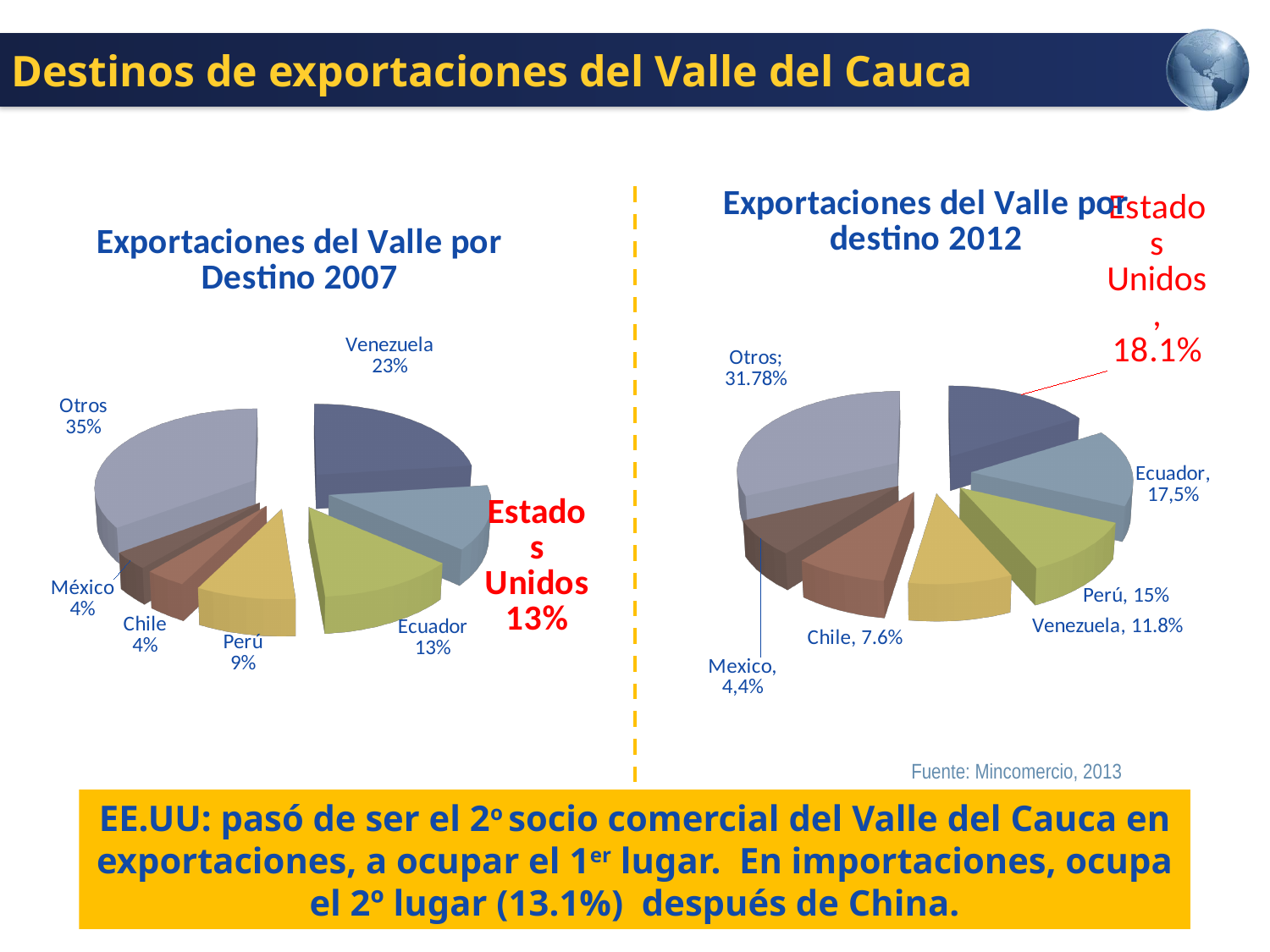
In the 'Exportaciones del Valle por Destino 2007' chart, which named country has the largest share? Venezuela In the 'Exportaciones del Valle por Destino 2007' chart, what share does Venezuela have? 23% In the 'Exportaciones del Valle por Destino 2007' chart, what share does Estados Unidos have? 13% In the 'Exportaciones del Valle por destino 2012' chart, what share does Estados Unidos have? 18.1% What is the title of the pie chart on the left side of the slide? Exportaciones del Valle por Destino 2007 In the 'Exportaciones del Valle por Destino 2007' chart, what is the difference between the shares of Venezuela and Perú? 14% In the 'Exportaciones del Valle por destino 2012' chart, what share does Otros have? 31.78% In the 'Exportaciones del Valle por Destino 2007' chart, how many slices does the pie have? 7 In the 'Exportaciones del Valle por destino 2012' chart, which category has the smallest share? Mexico In the 'Exportaciones del Valle por destino 2012' chart, what share does Chile have? 7.6% What kind of chart is 'Exportaciones del Valle por Destino 2007'? Pie chart In the 'Exportaciones del Valle por destino 2012' chart, which is larger, the share of Perú or the share of Venezuela? Perú